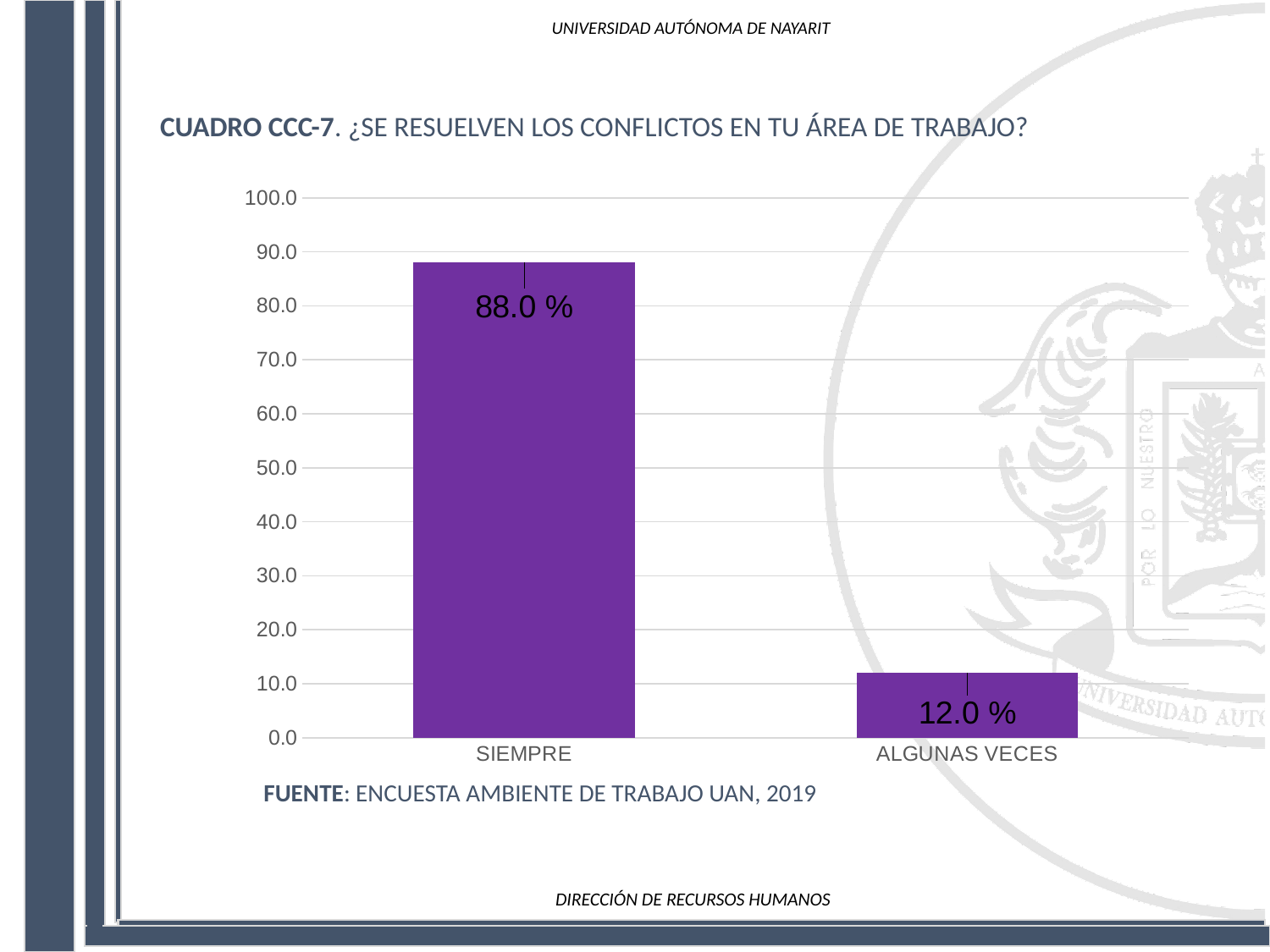
Which category has the highest value? SIEMPRE How many categories are shown on the x axis? 2 What is the value for SIEMPRE? 88.0 % What is the title of the chart? CUADRO CCC-7. ¿SE RESUELVEN LOS CONFLICTOS EN TU ÁREA DE TRABAJO? What kind of chart is shown on the slide? bar chart What source is cited below the chart? ENCUESTA AMBIENTE DE TRABAJO UAN, 2019 Is the value for ALGUNAS VECES greater or less than 20.0? less What is the difference between the values for SIEMPRE and ALGUNAS VECES? 76.0 % Is the value for SIEMPRE greater or less than 80.0? greater What is the value for ALGUNAS VECES? 12.0 % Which category has the lowest value? ALGUNAS VECES Which is larger, the value for SIEMPRE or the value for ALGUNAS VECES? SIEMPRE